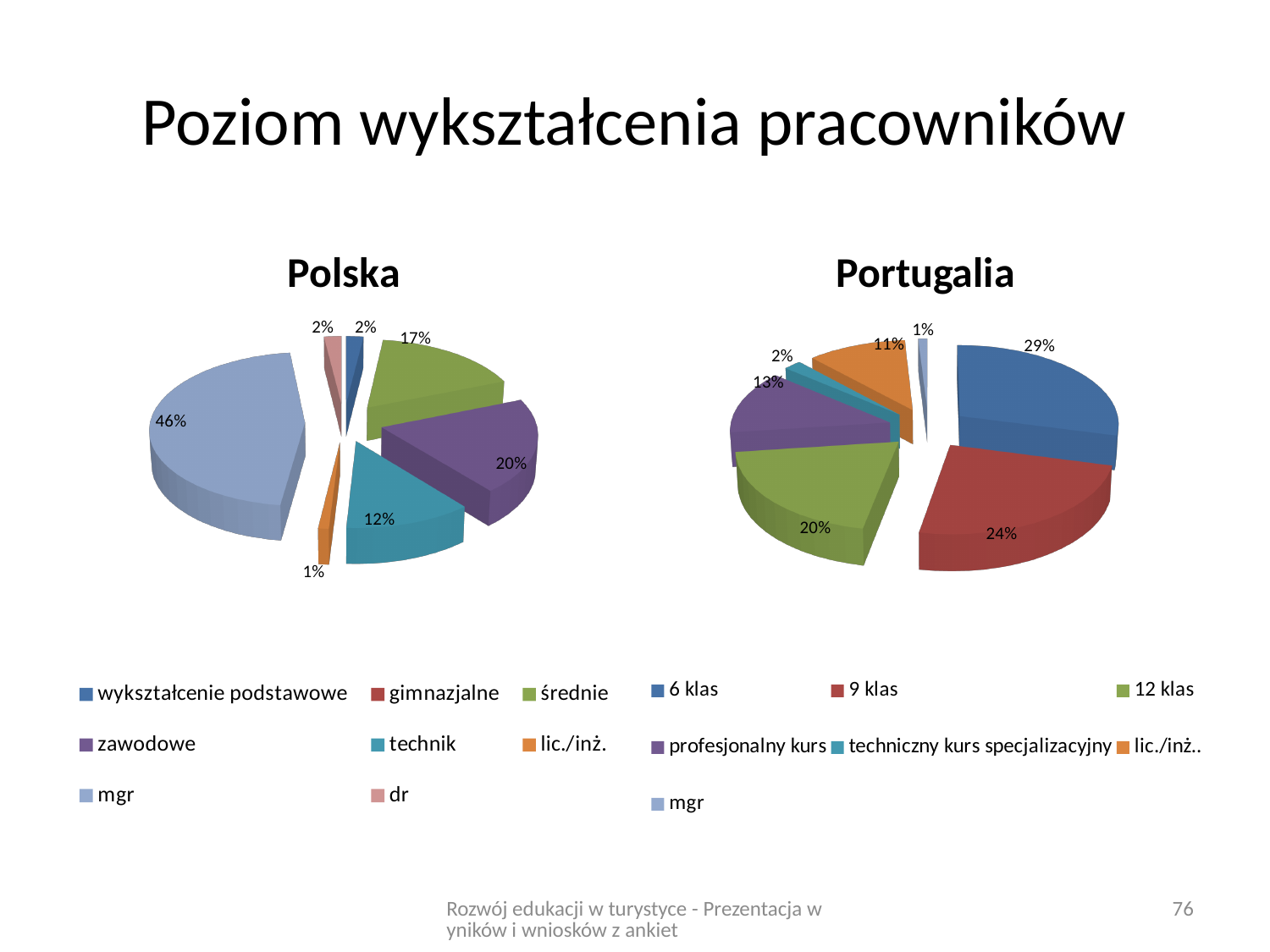
In the Portugalia chart, what share is shown for 6 klas? 29% In the Portugalia chart, which category has the largest share? 6 klas In the Polska chart, what percentage is shown for technik? 12% In the Polska chart, which education level has the largest share? mgr How many entries does the legend of the Portugalia chart list? 7 What type of chart is used for Polska? Pie chart In the Portugalia chart, which category has the smallest share? mgr In the Polska chart, what is the difference between the zawodowe and średnie shares? 3% In the Portugalia chart, what percentage is shown for profesjonalny kurs? 13% In the Polska chart, which education level has the smallest labelled share? lic./inż. In the Polska chart, what share of employees have mgr education? 46% In the Portugalia chart, which is larger: 9 klas or 12 klas? 9 klas